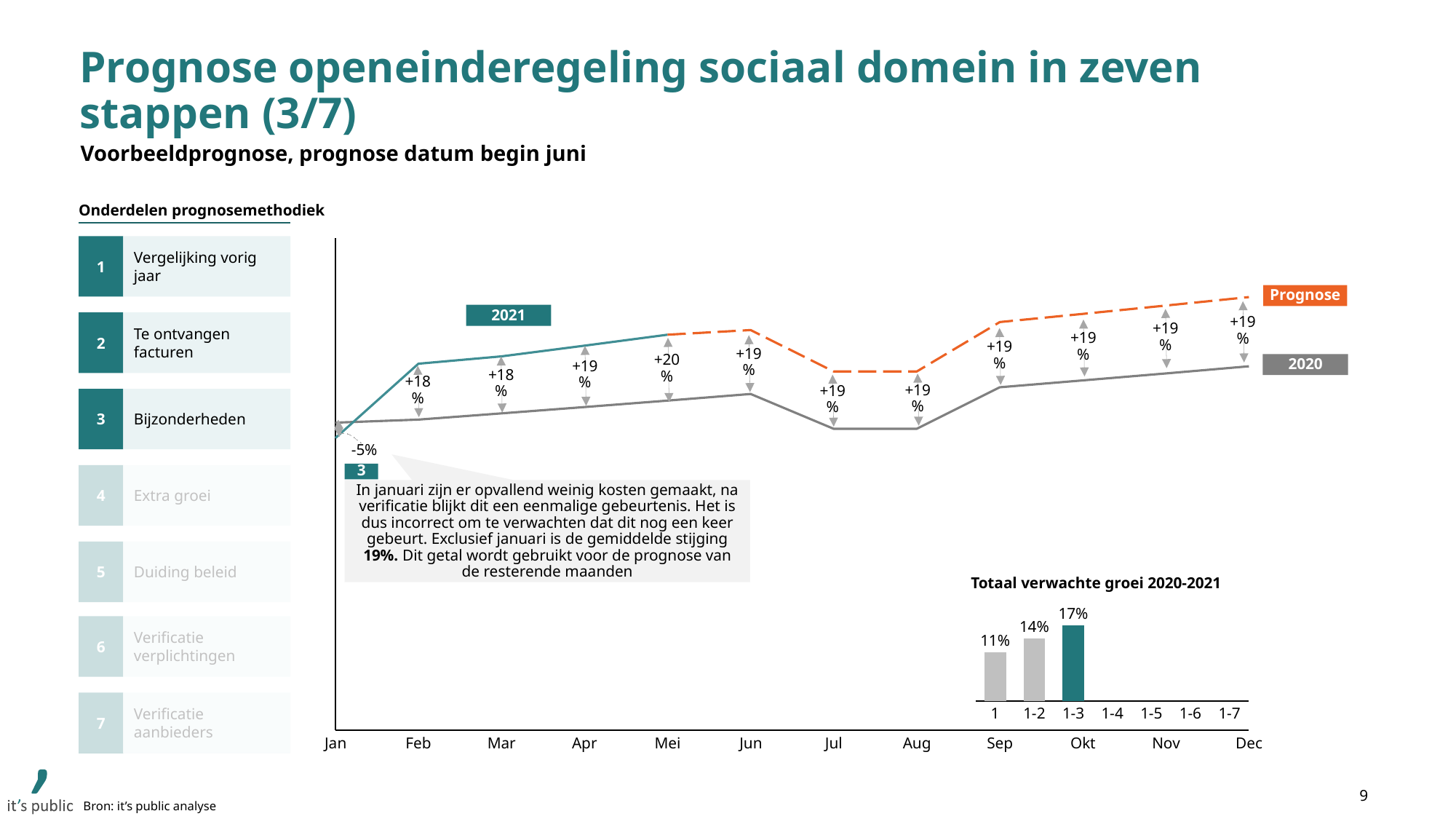
In the bar chart 'Totaal verwachte groei 2020-2021', do the plotted values rise or fall from left to right? rise In the bar chart 'Totaal verwachte groei 2020-2021', which category has the highest value? 1-3 What kind of chart is the small chart titled 'Totaal verwachte groei 2020-2021'? bar chart In the bar chart 'Totaal verwachte groei 2020-2021', what is the value for category 1-2? 14% In the bar chart 'Totaal verwachte groei 2020-2021', what is the value for category 1? 11% In the bar chart 'Totaal verwachte groei 2020-2021', which category has the lowest plotted value? 1 In the bar chart 'Totaal verwachte groei 2020-2021', how many bars are plotted? 3 In the large monthly chart, how many series are labelled (2021, 2020, Prognose)? 3 In the bar chart 'Totaal verwachte groei 2020-2021', what is the difference between the values for 1-3 and 1? 6 percentage points In the bar chart 'Totaal verwachte groei 2020-2021', what is the value for category 1-3? 17% In the large monthly chart, what percentage label is shown for Mei? +20% In the large monthly chart, what percentage label is shown for Jan? -5%